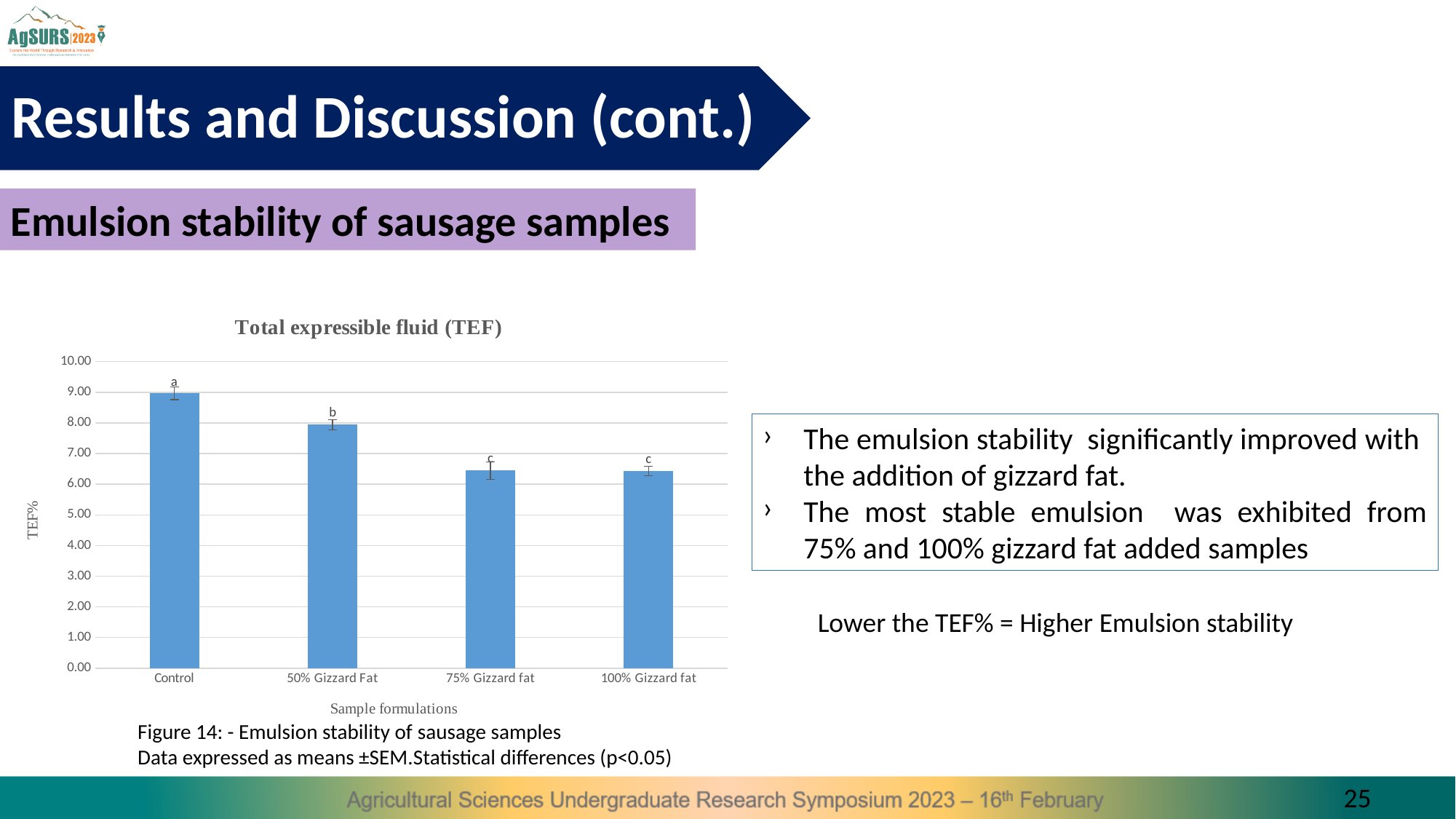
Is the TEF% value for 50% Gizzard Fat greater or less than 9.00? less Which sample formulation has the highest TEF% value? Control What kind of chart is shown on the slide? bar chart Is the TEF% value for 100% Gizzard fat greater or less than 6.00? greater What is the title of the chart? Total expressible fluid (TEF) Is the TEF% value for 50% Gizzard Fat greater or less than 7.00? greater Which has a larger TEF% value, Control or 50% Gizzard Fat? Control Do the TEF% values generally rise or fall moving from Control to 100% Gizzard fat along the x axis? fall How many sample formulations are plotted on the chart? 4 Which has a larger TEF% value, 50% Gizzard Fat or 75% Gizzard fat? 50% Gizzard Fat